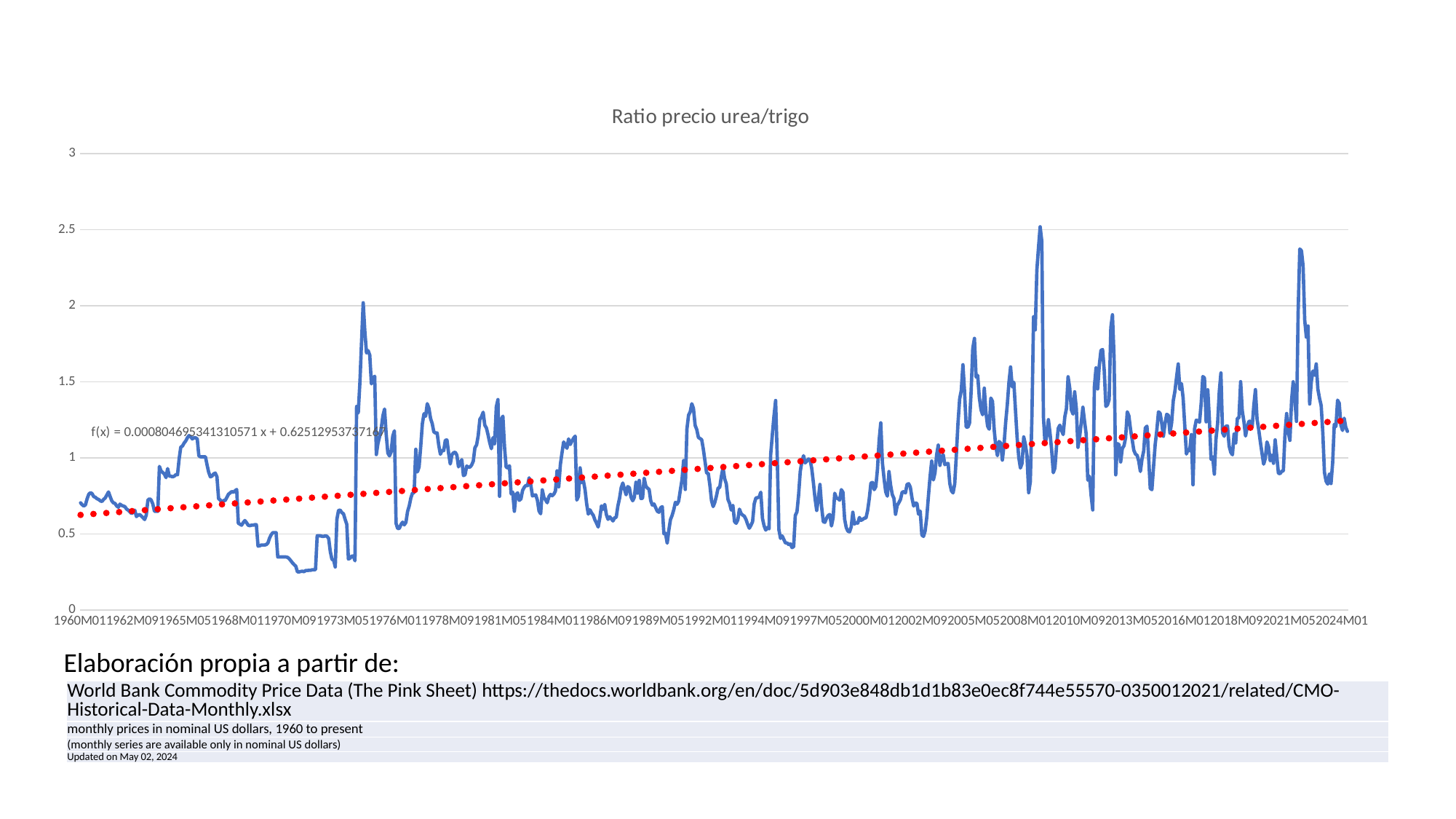
Is the lowest point of the blue line, around 1970M09, greater or less than 0.5? less What is the highest value shown on the vertical axis? 3 Is the value of the blue line at 1960M01 greater or less than 1? less Is the peak of the blue line near 2021M05 greater or less than 2.5? less Is the value of the blue line around 1970M09 greater or less than the value around 2008M01? less What is the title of the chart? Ratio precio urea/trigo What kind of chart is shown on the slide? line chart Which period has the higher peak in the blue line: around 1976M01 or around 2008M01? around 2008M01 Does the red dotted trendline rise or fall from left to right? rise